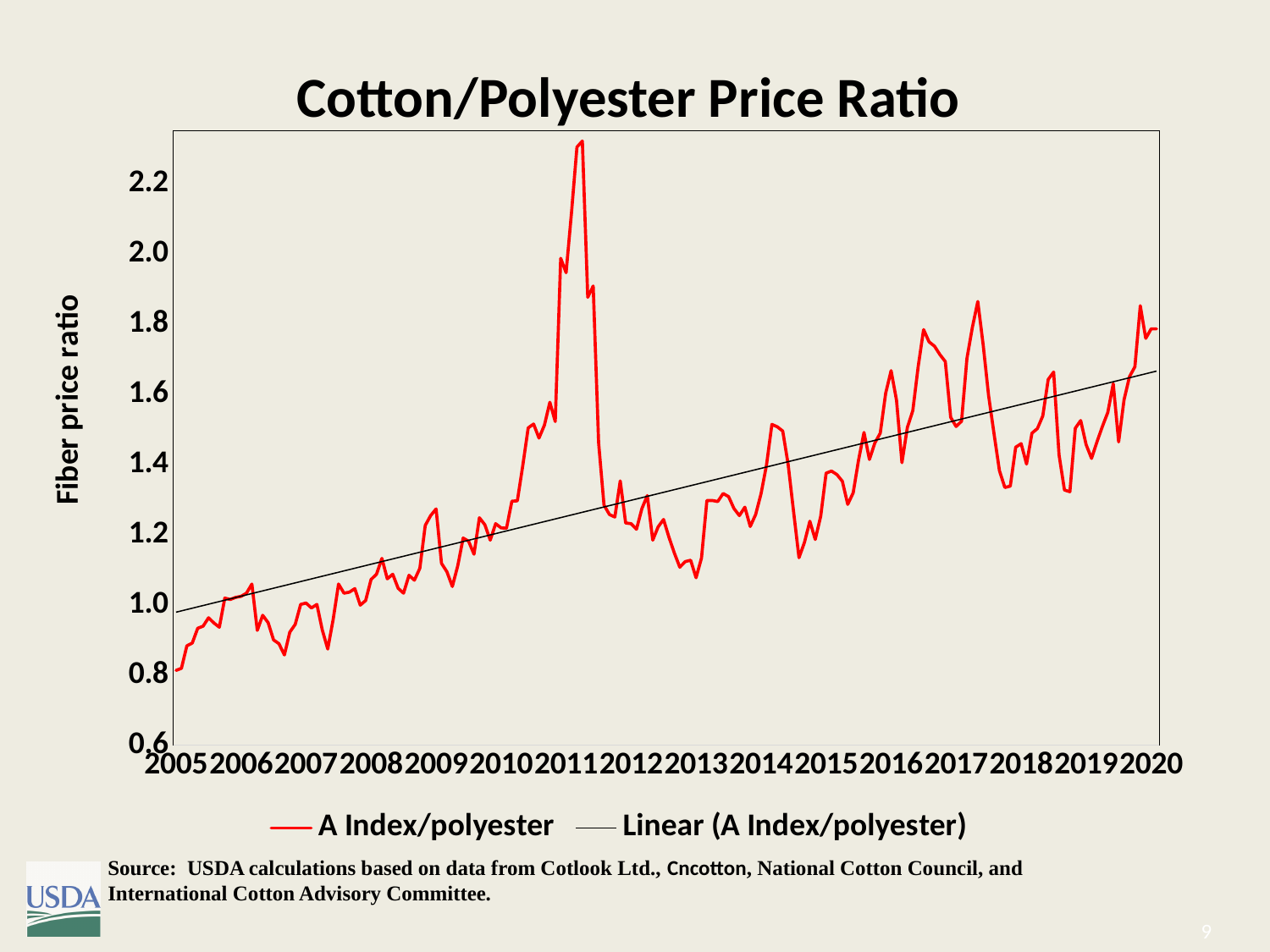
Is the A Index/polyester value at the start of 2005 greater or less than 1.0? less What is the label on the vertical axis? Fiber price ratio Does the Linear (A Index/polyester) trendline rise or fall from 2005 to 2020? rise How many year labels are shown on the horizontal axis? 16 What kind of chart is shown on the slide? line chart How many series does the legend list? 2 Is the A Index/polyester value at 2020 greater or less than 1.6? greater Is the peak A Index/polyester value in 2011 greater or less than 2.2? greater What is the title of the chart? Cotton/Polyester Price Ratio Which is larger, the A Index/polyester value at 2005 or at 2020? 2020 In which year does the A Index/polyester series reach its highest peak? 2011